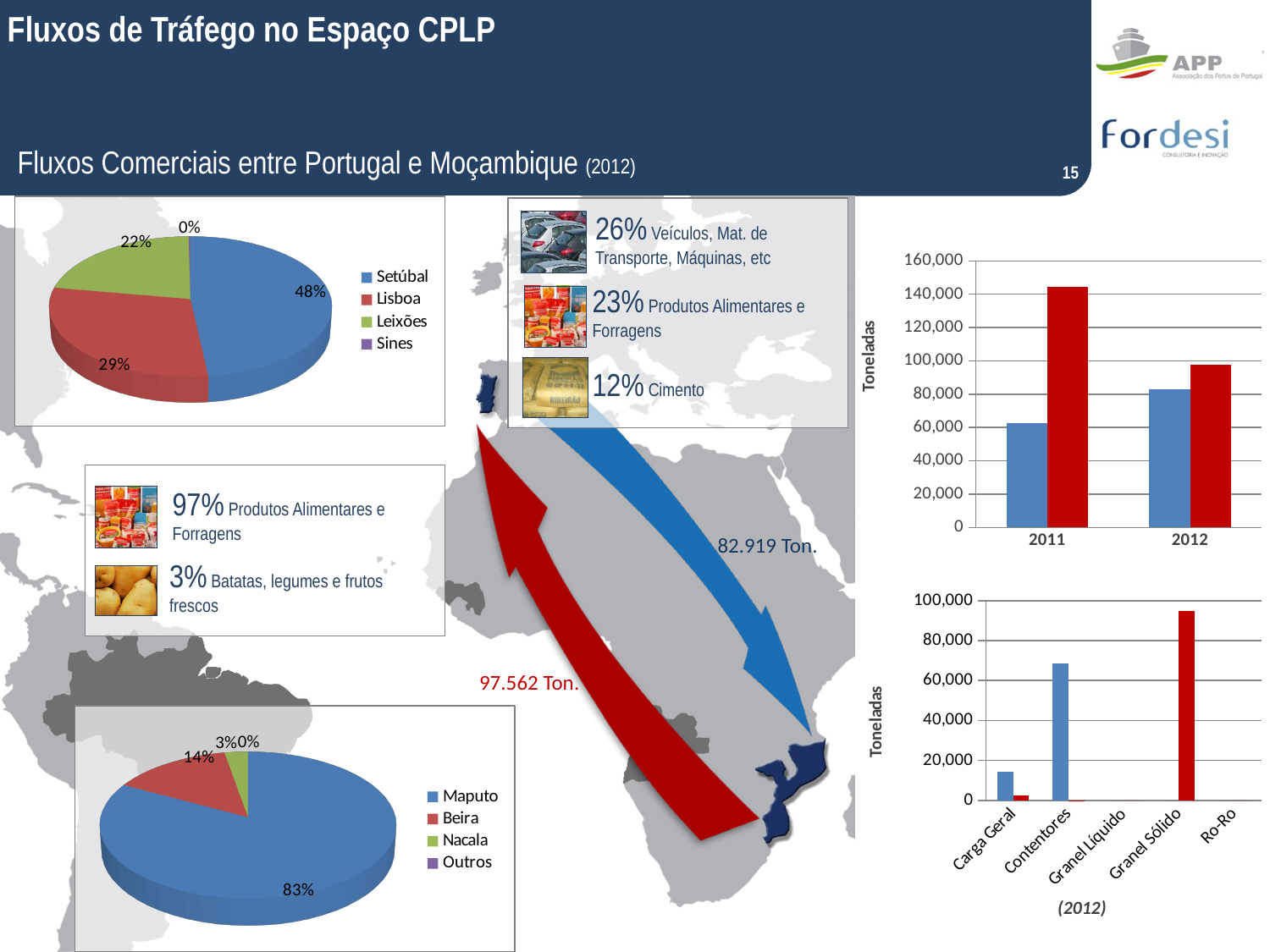
What type of chart is the bottom-left chart showing Maputo, Beira, Nacala and Outros? Pie chart In the top-left pie chart, what is the difference between the shares of Setúbal and Lisboa? 19% In the top-right bar chart, is the red bar for 2011 greater or less than 140,000? greater In the bottom-left pie chart, what share does Maputo have? 83% In the top-left pie chart, which port has the largest share? Setúbal In the top-right bar chart, is the blue bar for 2012 larger or smaller than the blue bar for 2011? larger In the top-left pie chart, what share does Leixões have? 22% In the top-left pie chart, what share does Setúbal have? 48% In the top-left pie chart, how many categories does the legend list? 4 In the bottom-left pie chart, which port has the smallest non-zero share? Nacala In the bottom-right bar chart, how many categories are shown on the x axis? 5 In the bottom-left pie chart, what share does Beira have? 14%